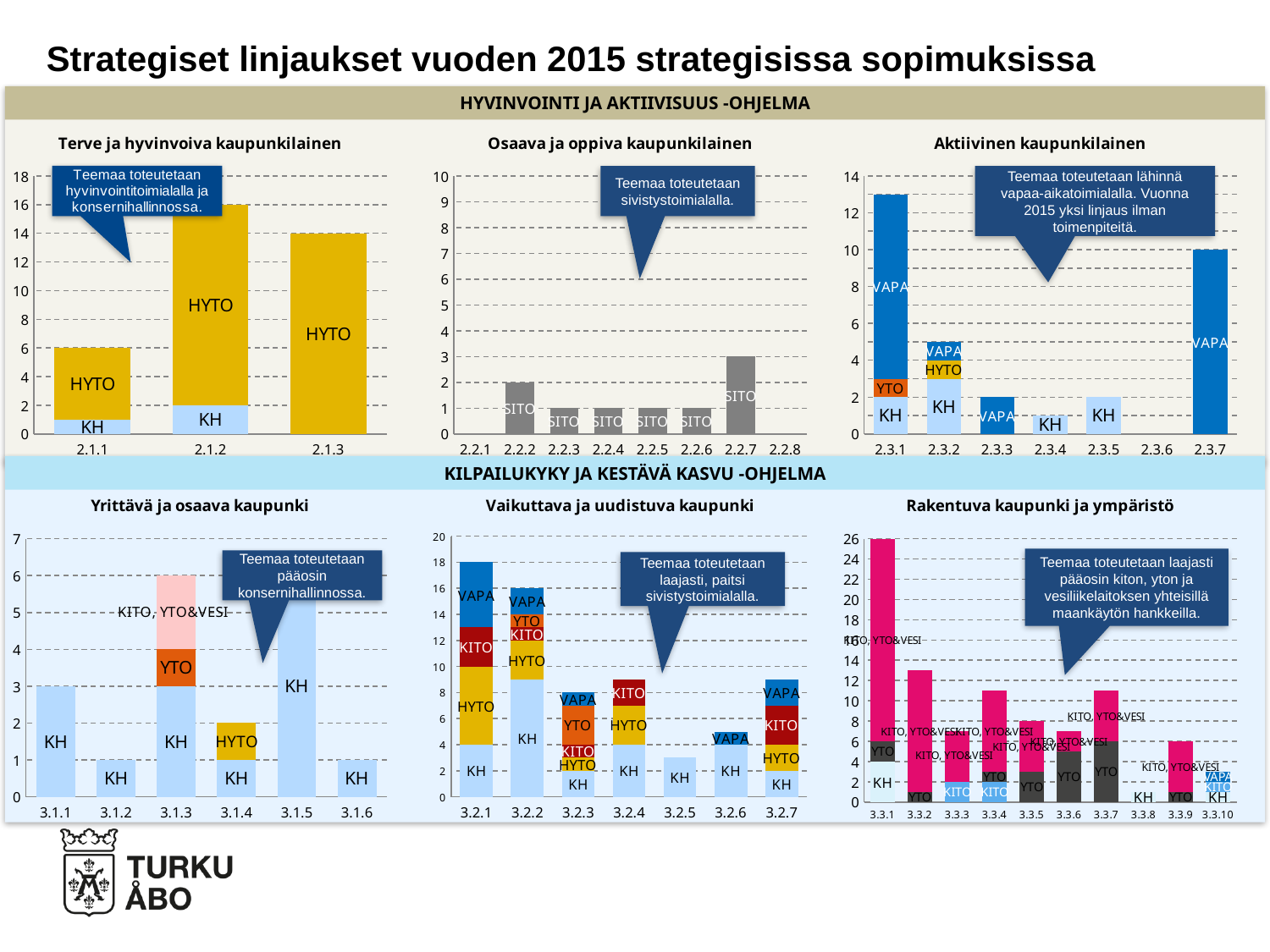
In the chart titled "Aktiivinen kaupunkilainen", what is the value for 2.3.7? 10 In the chart titled "Rakentuva kaupunki ja ympäristö", how many categories are shown on the x axis? 10 In the chart titled "Terve ja hyvinvoiva kaupunkilainen", what is the total height of the bar for 2.1.2? 16 In the chart titled "Aktiivinen kaupunkilainen", which category has the highest bar? 2.3.1 In the chart titled "Osaava ja oppiva kaupunkilainen", what is the value for 2.2.7? 3 In the chart titled "Yrittävä ja osaava kaupunki", what is the value for 3.1.1? 3 In the chart titled "Terve ja hyvinvoiva kaupunkilainen", which category has the lowest bar? 2.1.1 In the chart titled "Aktiivinen kaupunkilainen", is the total for 2.3.1 greater or less than 12? greater In the chart titled "Rakentuva kaupunki ja ympäristö", what is the total height of the bar for 3.3.1? 26 In the chart titled "Vaikuttava ja uudistuva kaupunki", which category has the highest bar? 3.2.1 In the chart titled "Osaava ja oppiva kaupunkilainen", how many categories are shown on the x axis? 8 In the chart titled "Vaikuttava ja uudistuva kaupunki", which category has the lowest bar? 3.2.5